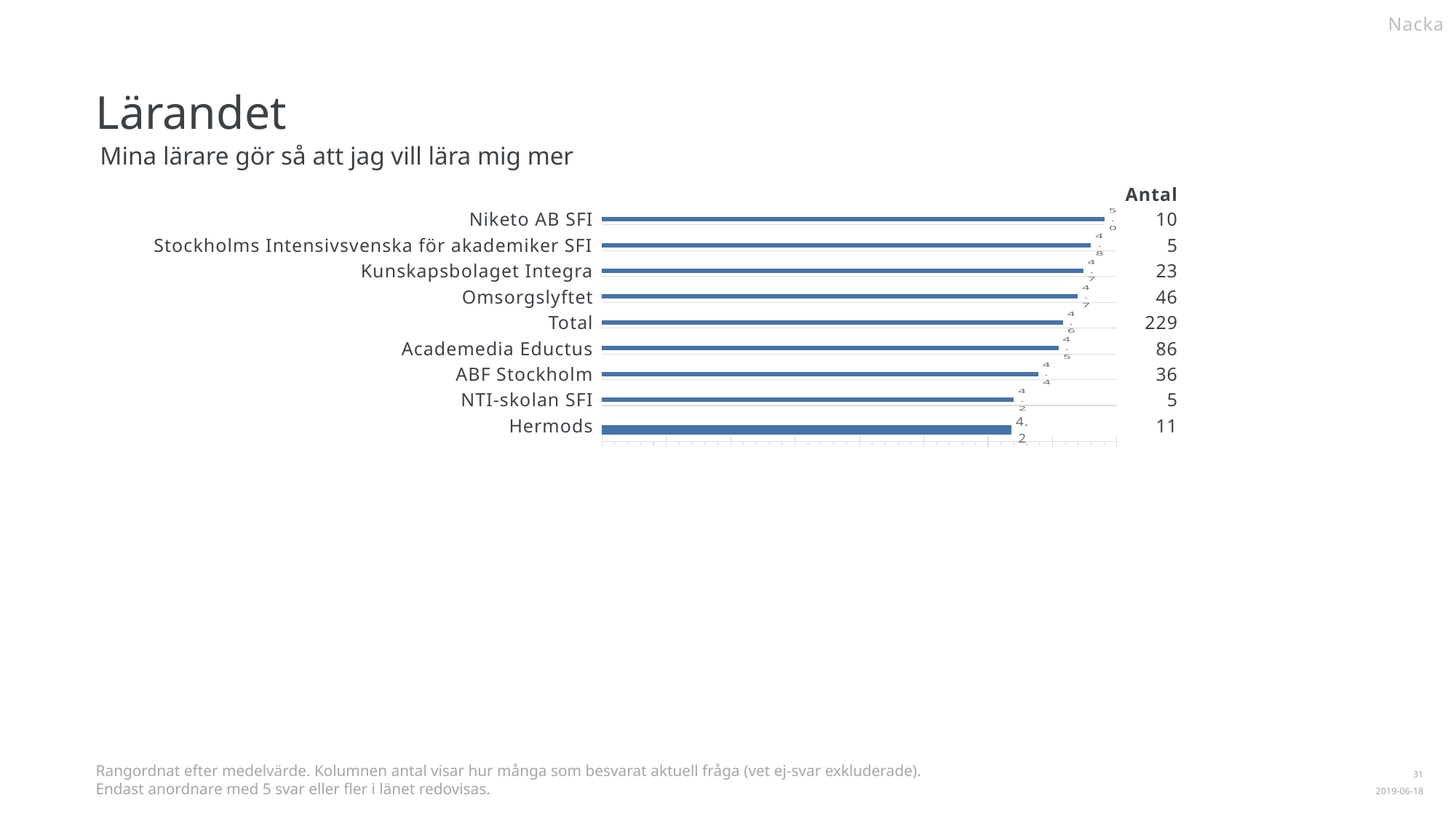
What is the Antal value for Omsorgslyftet? 46 What is the data label value on the bar for Niketo AB SFI? 5.0 Which has a larger Antal value, Kunskapsbolaget Integra or ABF Stockholm? ABF Stockholm What is the difference between the Antal values for Academedia Eductus and Omsorgslyftet? 40 What is the data label value on the bar for Total? 4.6 How many categories (bars) are shown in the chart? 9 What kind of chart is shown on the slide? bar chart What is the Antal value for Academedia Eductus? 86 Which two categories have the smallest Antal value, and what is it? Stockholms Intensivsvenska för akademiker SFI and NTI-skolan SFI, 5 Which category has the longest bar in the chart? Niketo AB SFI What is the subtitle (question text) shown above the chart? Mina lärare gör så att jag vill lära mig mer What is the Antal value for Total? 229